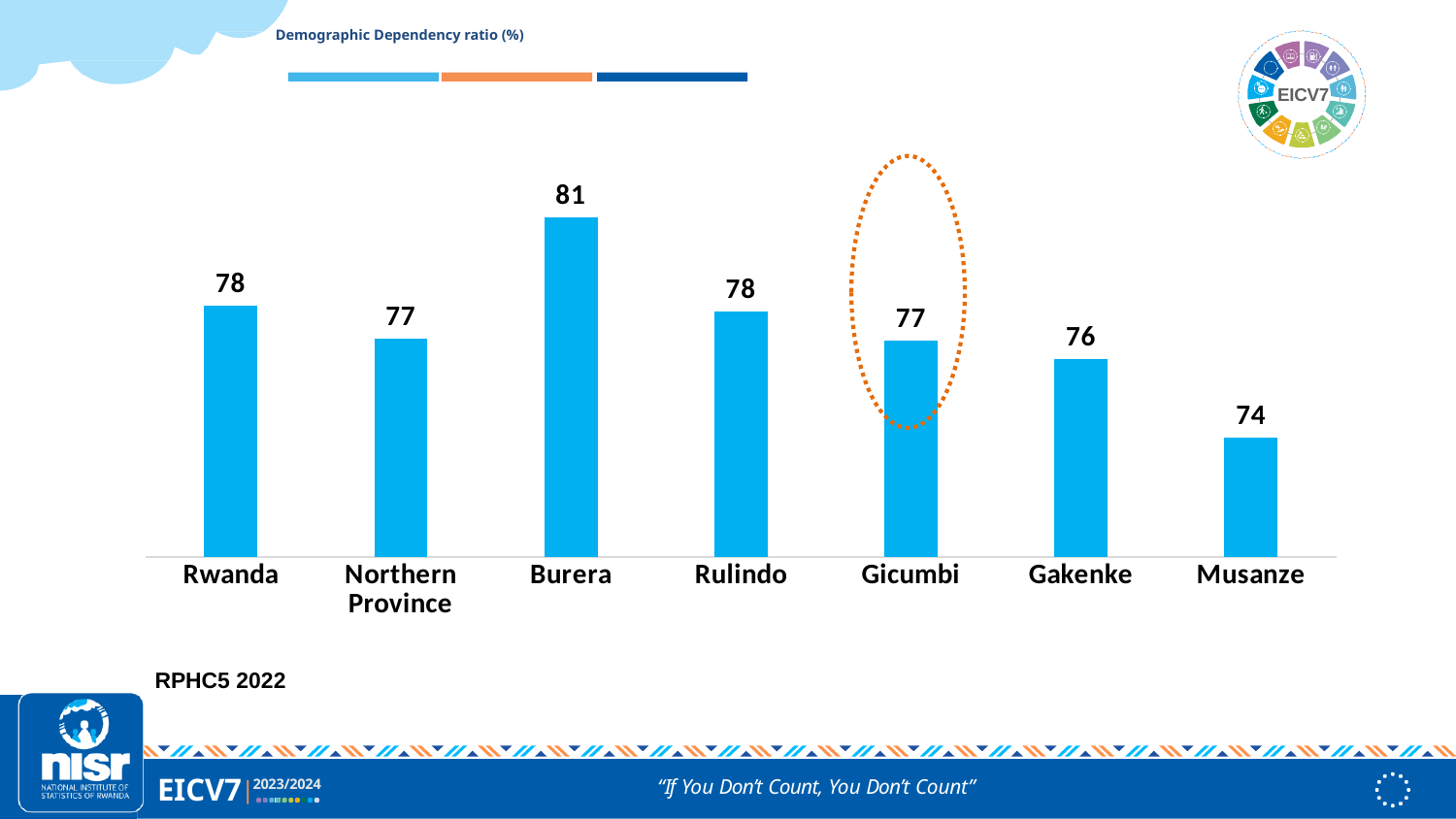
What is the difference between the dependency ratio of Burera and Musanze? 7 Which category has the lowest demographic dependency ratio? Musanze Which category has the highest demographic dependency ratio? Burera What is the demographic dependency ratio for Musanze? 74 Which category is highlighted with a dotted orange circle? Gicumbi What is the demographic dependency ratio for Burera? 81 What is the demographic dependency ratio for Gicumbi? 77 How many categories are shown in the chart? 7 Which has a higher dependency ratio, Burera or Gakenke? Burera What is the difference between the dependency ratio of Rwanda and Gakenke? 2 What kind of chart is shown on the slide? Bar chart What is the demographic dependency ratio for Rwanda? 78